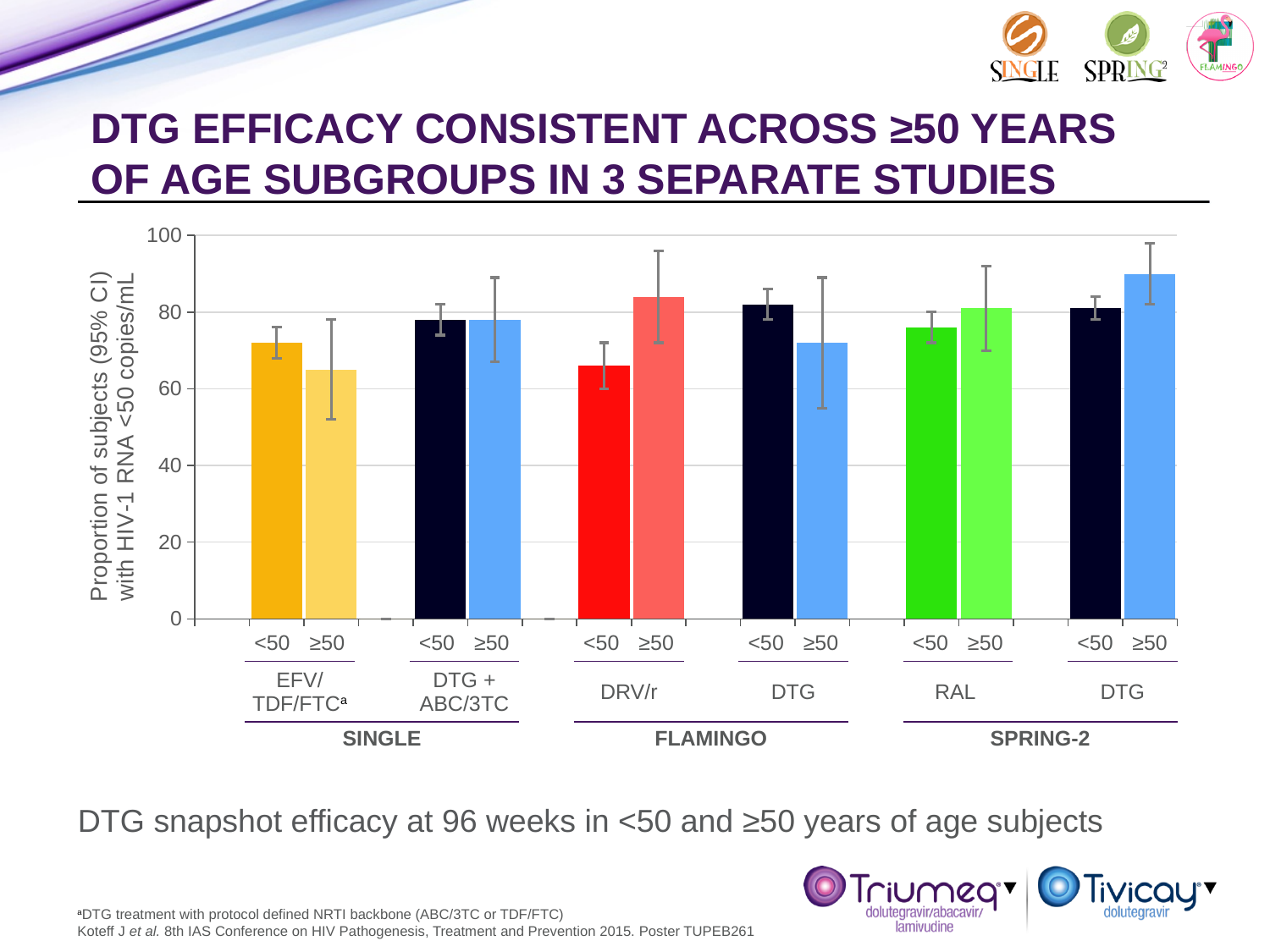
Is the value for the EFV/TDF/FTC ≥50 group in SINGLE greater or less than 80? less Is the value for the DRV/r ≥50 group in FLAMINGO greater or less than 80? greater In the FLAMINGO DRV/r arm, which age group has the larger value, <50 or ≥50? ≥50 Is the value for the DRV/r <50 group in FLAMINGO greater or less than 80? less In the SINGLE EFV/TDF/FTC arm, which age group has the larger value, <50 or ≥50? <50 What is the label of the y axis? Proportion of subjects (95% CI) with HIV-1 RNA <50 copies/mL How many bars are plotted in the chart? 12 What kind of chart is shown on the slide? bar chart In the FLAMINGO DTG arm, which age group has the larger value, <50 or ≥50? <50 Which bar is the highest in the chart? SPRING-2 DTG ≥50 How many studies are labelled along the bottom of the chart? 3